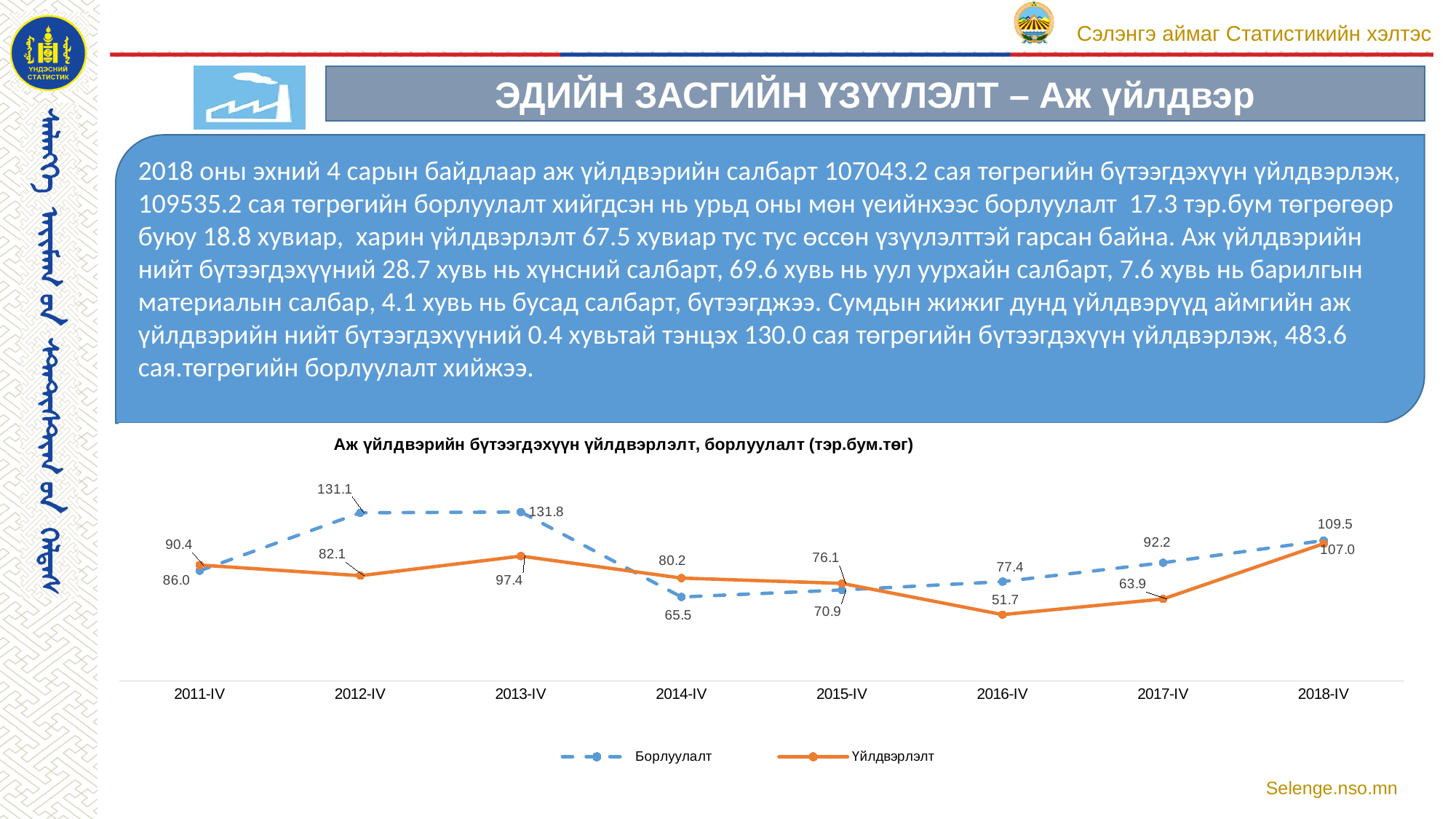
By how much did Борлуулалт increase from 2017-IV to 2018-IV? 17.3 What is the value of Үйлдвэрлэлт for 2016-IV? 51.7 What is the difference between Борлуулалт and Үйлдвэрлэлт in 2018-IV? 2.5 In 2014-IV, which series has the larger value, Борлуулалт or Үйлдвэрлэлт? Үйлдвэрлэлт How many series does the chart legend list? 2 What is the value of Борлуулалт for 2018-IV? 109.5 In which period is Үйлдвэрлэлт at its lowest? 2016-IV What kind of chart is shown on the slide? line chart In which period is Борлуулалт at its highest? 2013-IV What is the value of Борлуулалт for 2012-IV? 131.1 How many time points are plotted along the x axis of the chart? 8 Does Үйлдвэрлэлт rise or fall from 2013-IV to 2016-IV? fall